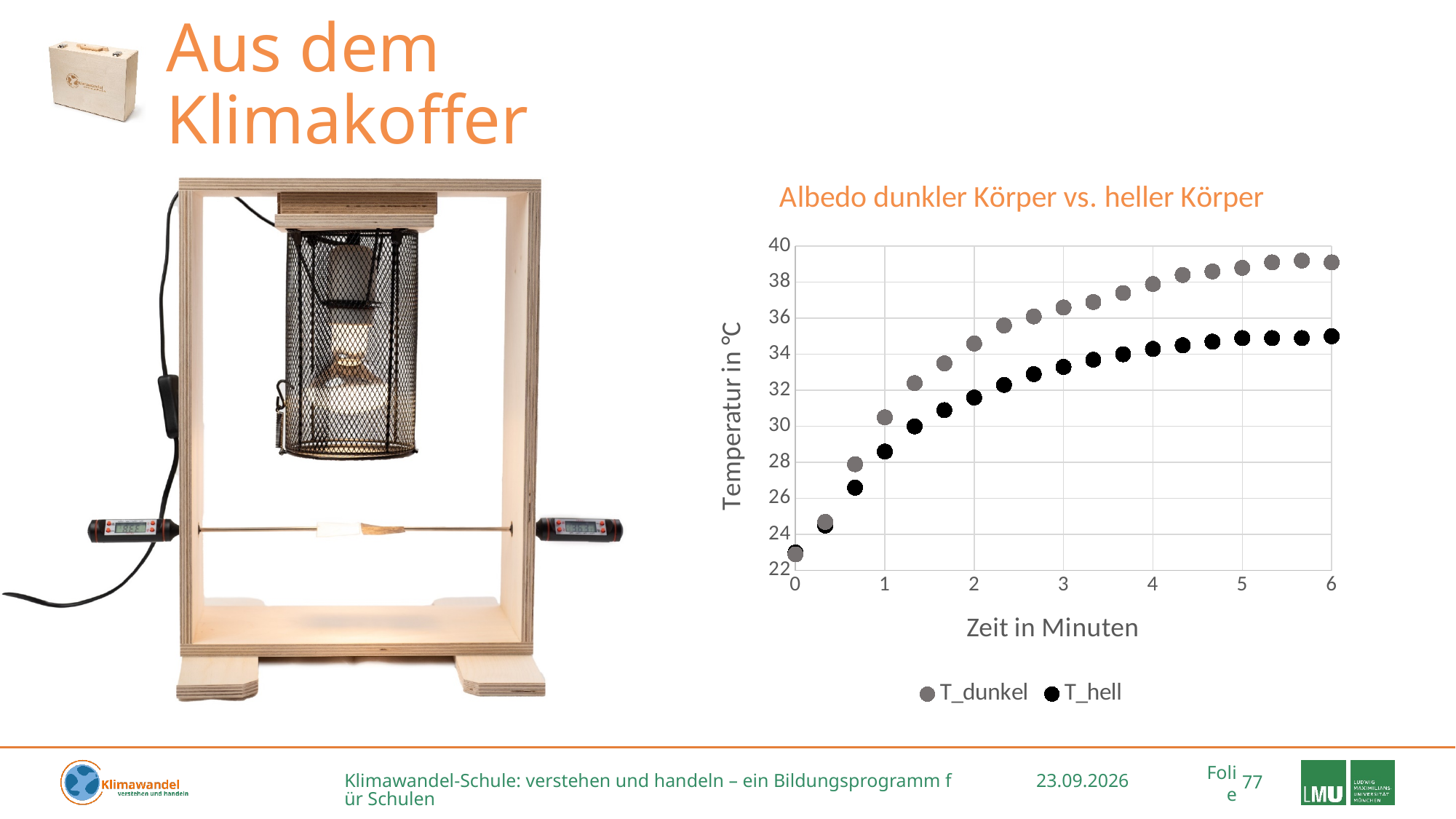
Do the T_dunkel values rise or fall as time increases along the x axis? rise Is the T_dunkel value at 2 minutes greater or less than 32? greater Is the T_hell value at 6 minutes greater or less than 36? less Is the T_dunkel value at 6 minutes greater or less than 38? greater What is the title of the chart? Albedo dunkler Körper vs. heller Körper At 6 minutes, which series has the higher temperature, T_dunkel or T_hell? T_dunkel Do the T_hell values rise or fall as time increases along the x axis? rise What kind of chart is shown on the slide? scatter chart How many series does the legend of the chart list? 2 What are the two series named in the chart legend? T_dunkel and T_hell